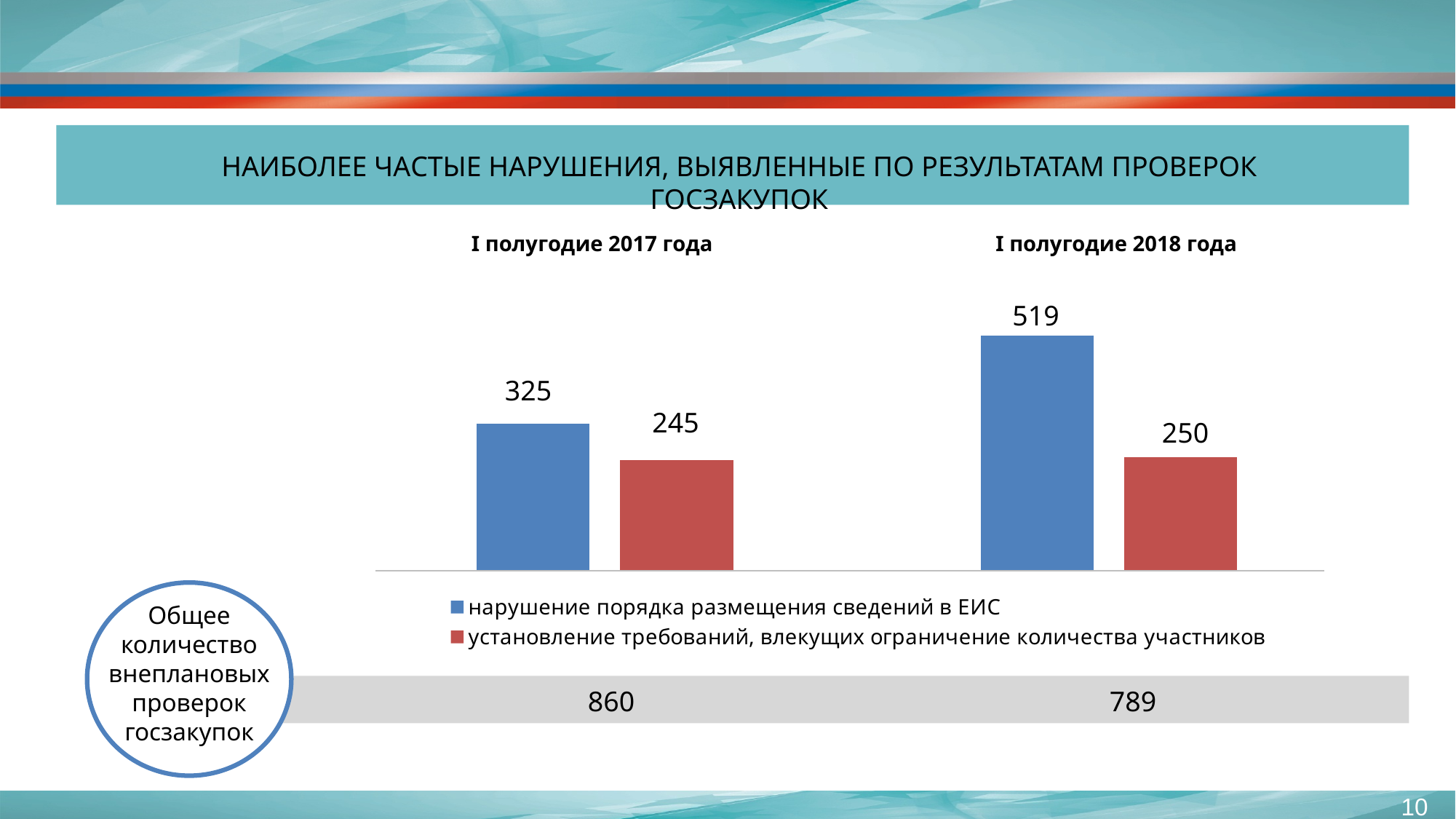
Which is larger in I полугодие 2017 года: 'нарушение порядка размещения сведений в ЕИС' or 'установление требований, влекущих ограничение количества участников'? нарушение порядка размещения сведений в ЕИС Which bar has the highest value on the chart? нарушение порядка размещения сведений в ЕИС, I полугодие 2018 года How many series does the legend list? 2 What colour are the bars for 'установление требований, влекущих ограничение количества участников'? red What is the value for 'нарушение порядка размещения сведений в ЕИС' in I полугодие 2017 года? 325 How many periods (categories) are shown on the chart? 2 Which bar has the lowest value on the chart? установление требований, влекущих ограничение количества участников, I полугодие 2017 года What is the value for 'нарушение порядка размещения сведений в ЕИС' in I полугодие 2018 года? 519 What is the value for 'установление требований, влекущих ограничение количества участников' in I полугодие 2018 года? 250 What kind of chart is shown on the slide? bar chart What is the value for 'установление требований, влекущих ограничение количества участников' in I полугодие 2017 года? 245 What is the difference between the values for 'нарушение порядка размещения сведений в ЕИС' in I полугодие 2018 года and I полугодие 2017 года? 194